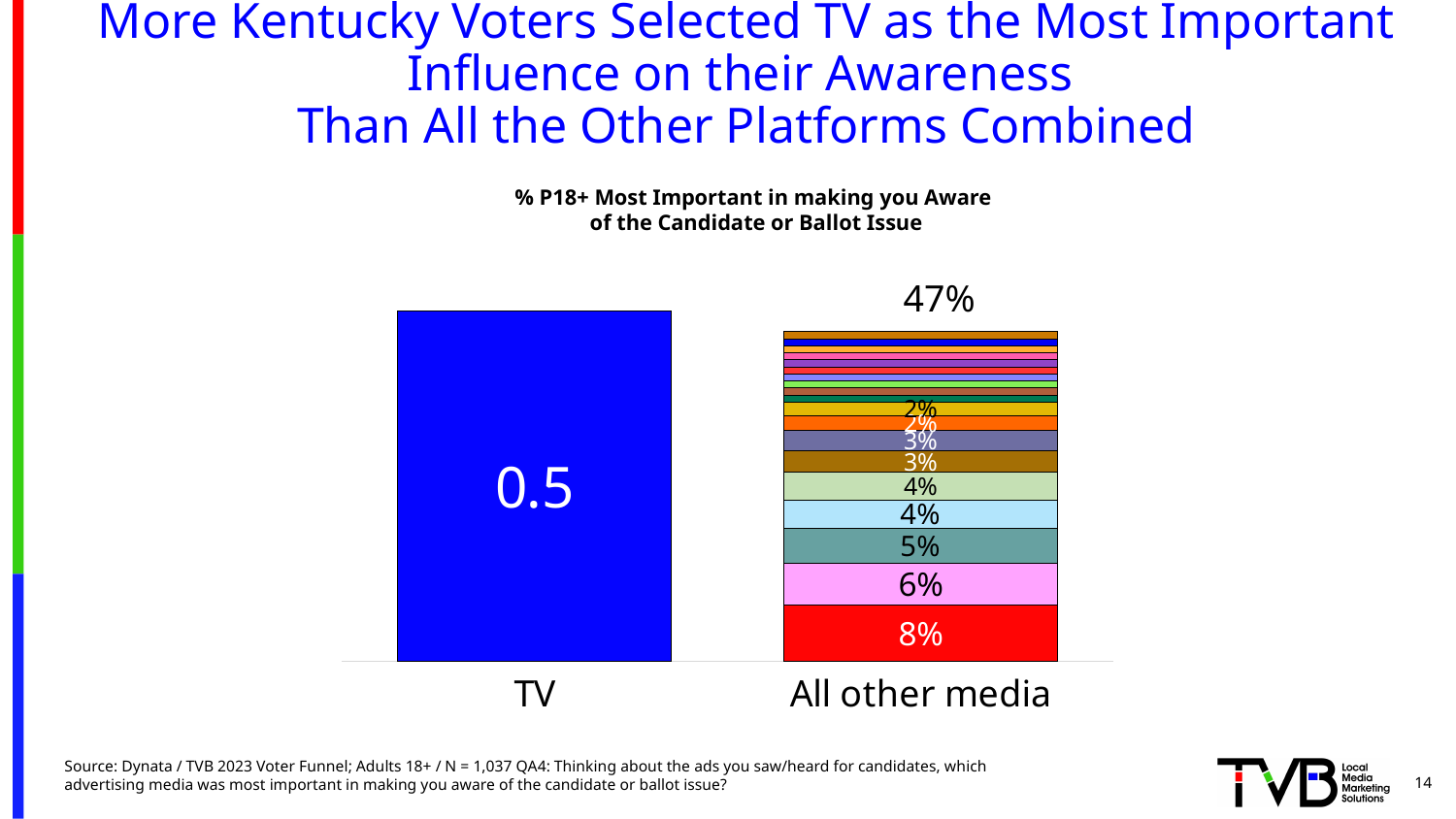
What total is printed above the All other media bar? 47% Which category has the highest value in the chart? TV What is the value of the second-largest segment in the All other media bar? 6% Which category has the taller bar, TV or All other media? TV Which of the two bars is a stacked bar, TV or All other media? All other media How many categories are shown on the x axis of the chart? 2 What colour is the TV bar? blue What kind of chart is shown on the slide? bar chart What value is printed on the TV bar? 0.5 What is the value of the largest segment in the All other media bar? 8% What is the difference between the largest (8%) and second-largest (6%) segments in the All other media bar? 2% What is the title of the chart? % P18+ Most Important in making you Aware of the Candidate or Ballot Issue